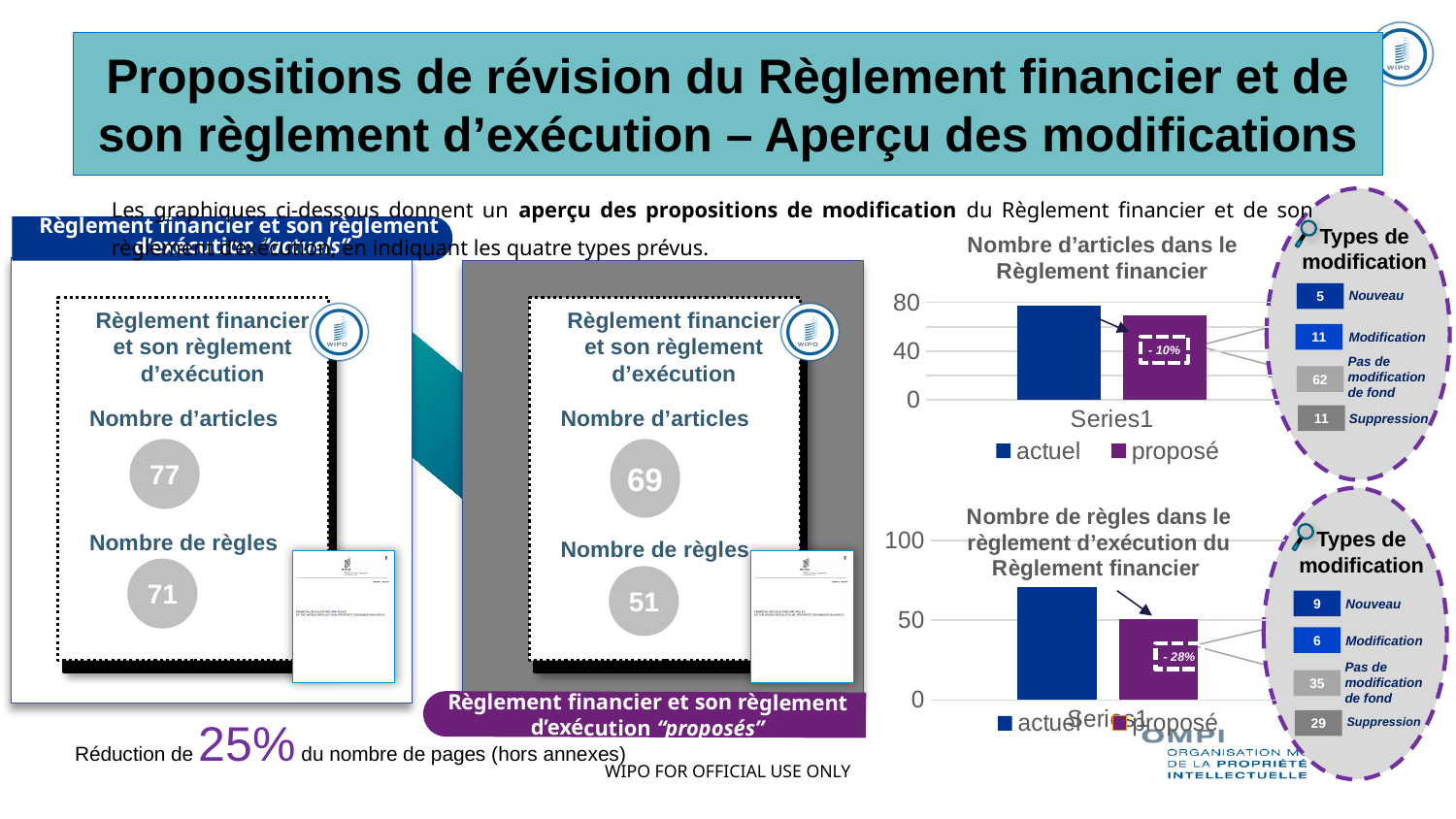
What kind of chart is the 'Nombre d'articles dans le Règlement financier' chart? bar chart In the 'Nombre d'articles dans le Règlement financier' chart, what percentage change is printed on the 'proposé' bar? - 10% In the 'Nombre de règles dans le règlement d'exécution du Règlement financier' chart, is the value for 'proposé' greater or less than 100? less In the 'Nombre d'articles dans le Règlement financier' chart, do the values rise or fall from 'actuel' to 'proposé'? fall In the 'Nombre d'articles dans le Règlement financier' chart, which bar is taller, 'actuel' or 'proposé'? actuel In the 'Nombre de règles dans le règlement d'exécution du Règlement financier' chart, which bar is taller, 'actuel' or 'proposé'? actuel What is the highest axis tick shown on the 'Nombre de règles dans le règlement d'exécution du Règlement financier' chart? 100 In the 'Nombre de règles dans le règlement d'exécution du Règlement financier' chart, is the value for 'actuel' greater or less than 50? greater In the 'Nombre de règles dans le règlement d'exécution du Règlement financier' chart, what percentage change is printed on the 'proposé' bar? - 28% How many series does the legend of the 'Nombre d'articles dans le Règlement financier' chart list? 2 In the 'Nombre d'articles dans le Règlement financier' chart, is the value for 'actuel' greater or less than 40? greater In the 'Nombre d'articles dans le Règlement financier' chart, what colour is the 'proposé' series? purple